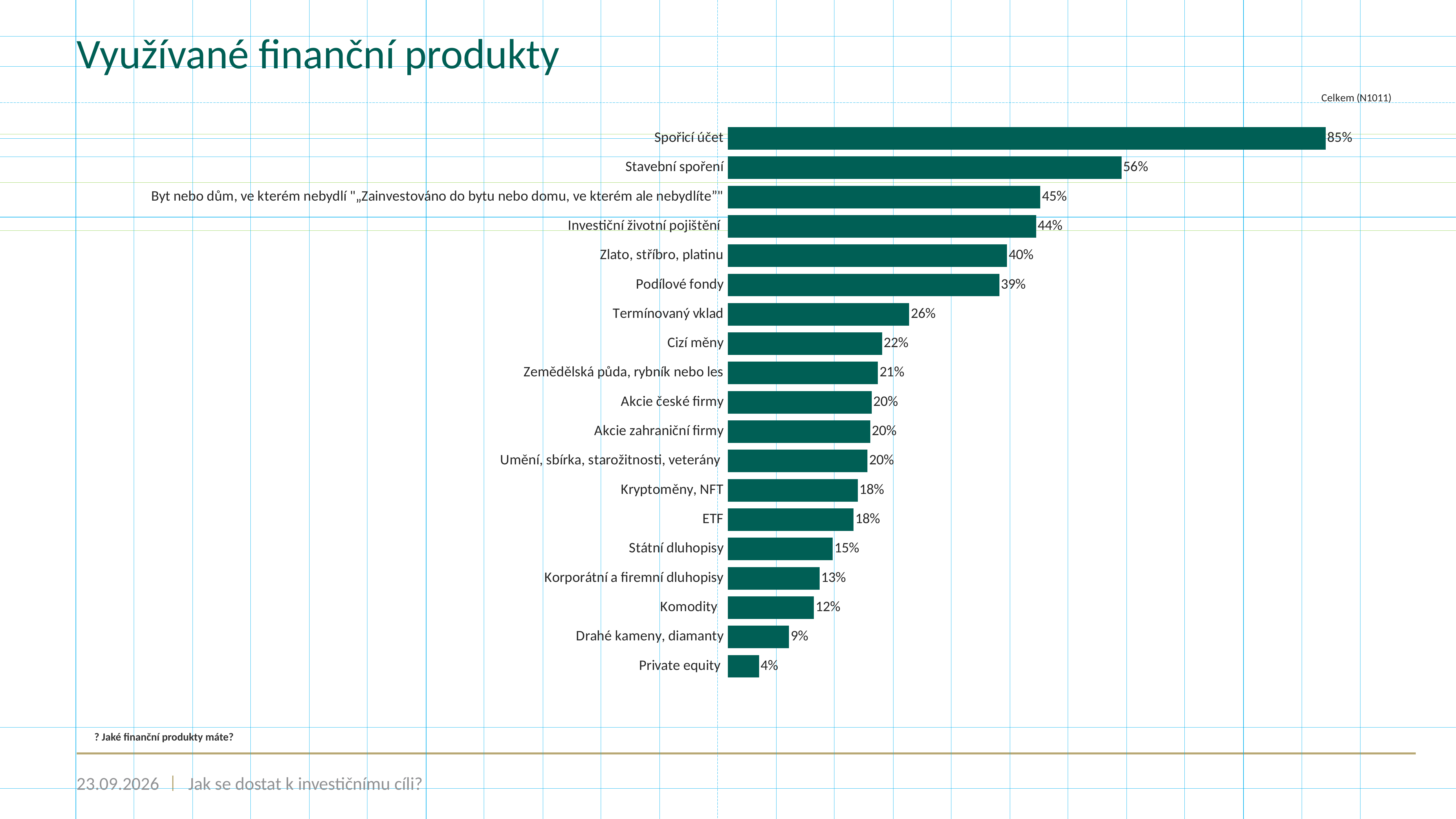
What is the value for Kryptoměny, NFT? 18% What is the value for Podílové fondy? 39% What is the value for Spořicí účet? 85% Which is larger, the value for Zlato, stříbro, platinu or the value for Státní dluhopisy? Zlato, stříbro, platinu What is the value for Komodity? 12% What is the difference between the values for Spořicí účet and Stavební spoření? 29% What is the difference between the values for Termínovaný vklad and Cizí měny? 4% Which category has the highest value? Spořicí účet What is the title of the slide? Využívané finanční produkty What kind of chart is shown on the slide? Bar chart How many categories are shown in the chart? 19 Which category has the lowest value? Private equity